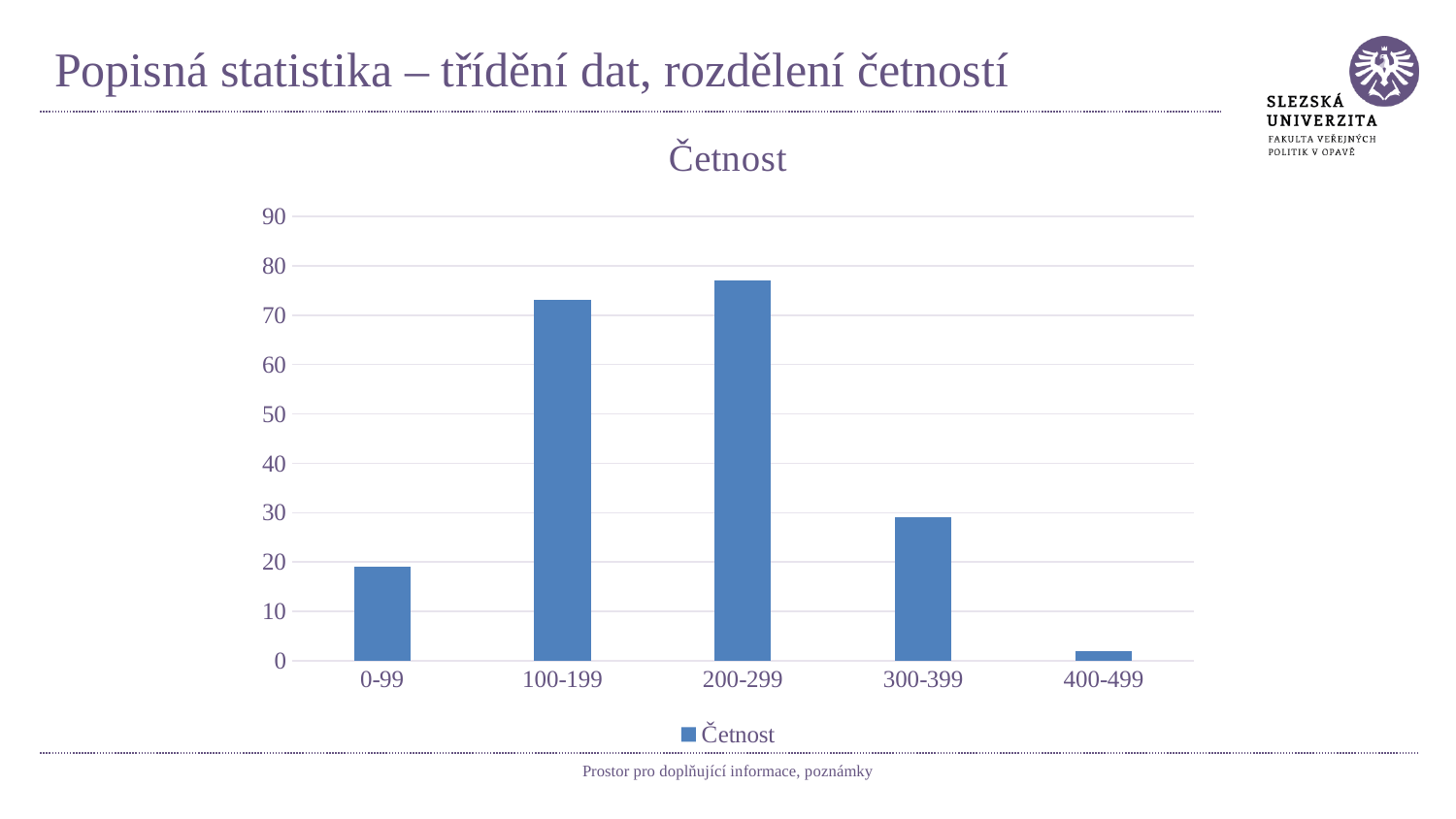
What is the title of the chart? Četnost Which category has the lowest value? 400-499 How many categories are shown on the x axis of the chart? 5 Which category has the highest value? 200-299 How many series does the legend list? 1 Is the value for 100-199 greater or less than 70? greater What kind of chart is shown on the slide? bar chart Is the value for 300-399 greater or less than 20? greater Which is larger, the value for 0-99 or the value for 300-399? 300-399 Is the value for 400-499 greater or less than 10? less